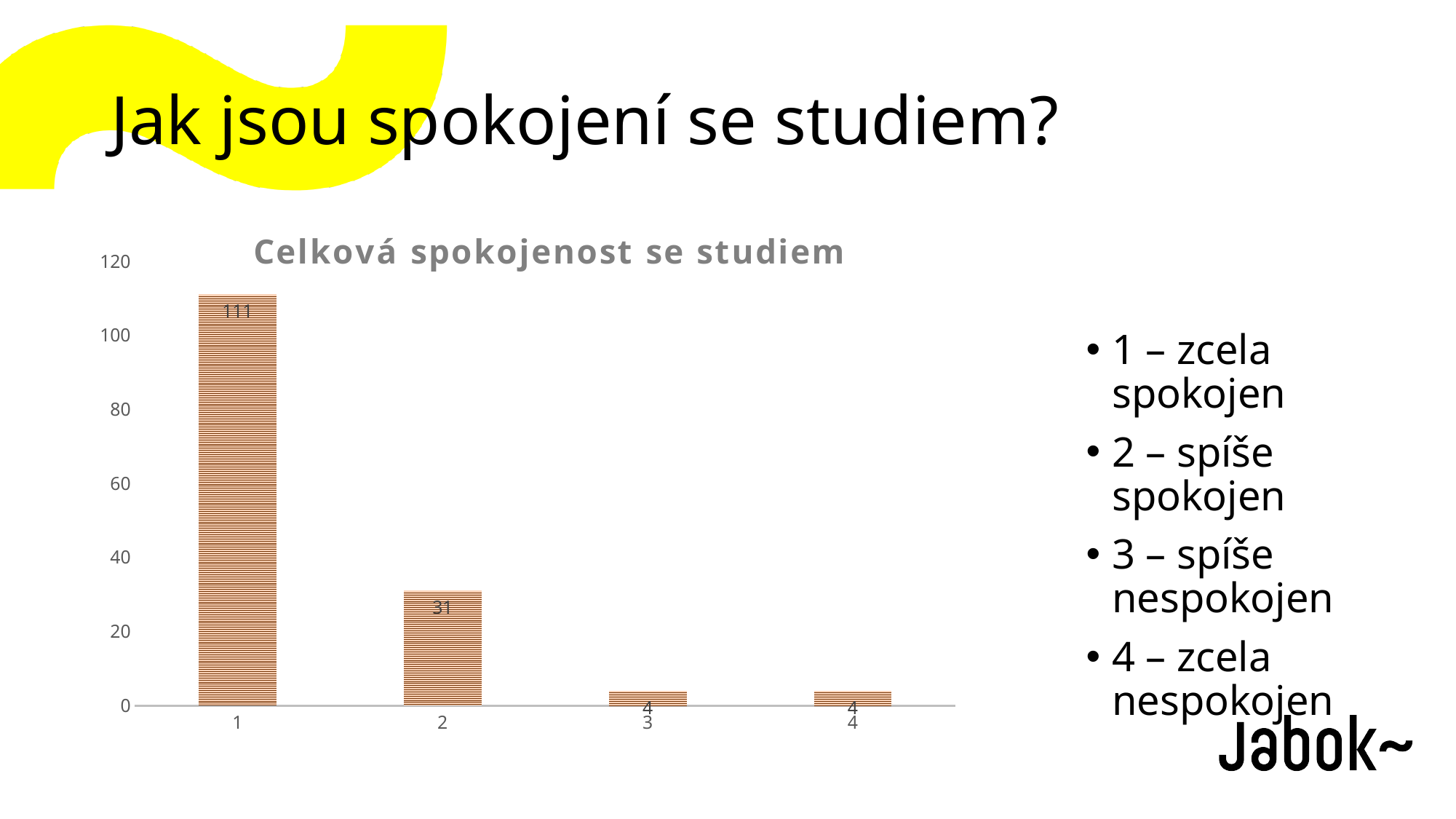
What is the title of the chart? Celková spokojenost se studiem Is the value for category 1 greater or less than 100? greater Do the values rise or fall from category 1 to category 3 along the x axis? fall What is the value for category 1 in the chart? 111 Which is larger, the value for category 2 or the value for category 3? category 2 What kind of chart is shown on the slide? bar chart How many categories are shown on the x axis? 4 What is the value for category 3 in the chart? 4 Which category has the highest value? 1 What is the difference between the values for category 1 and category 2? 80 What is the highest value shown on the vertical axis? 120 What is the value for category 2 in the chart? 31